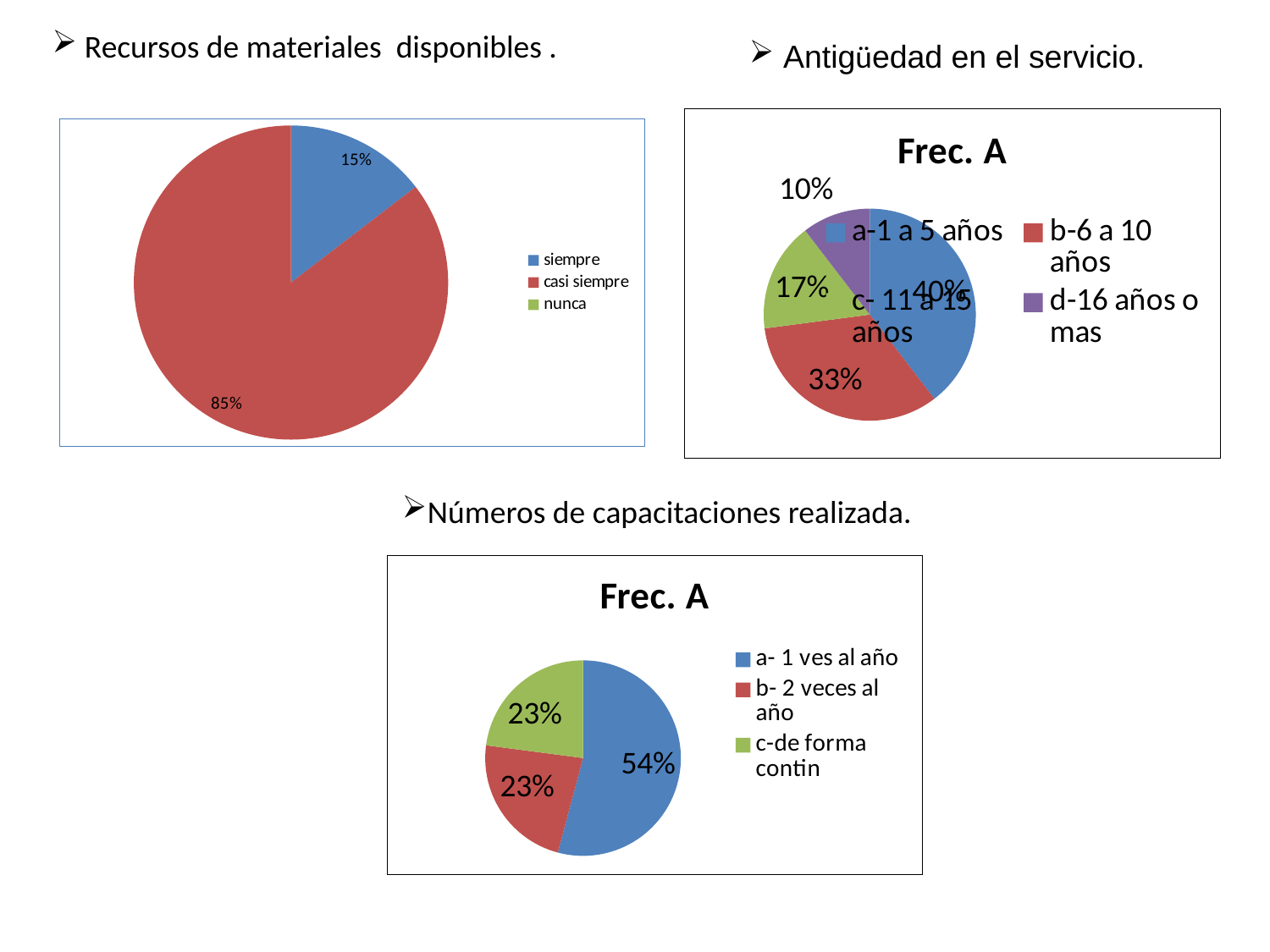
In the top-right pie chart (Antigüedad en el servicio), which category has the smallest slice? d-16 años o mas In the top-right pie chart (Antigüedad en el servicio), what percentage is shown for 'a-1 a 5 años'? 40% In the bottom pie chart (Números de capacitaciones realizada), what percentage is shown for 'a- 1 ves al año'? 54% In the top-right pie chart (Antigüedad en el servicio), what is the difference between the 'b-6 a 10 años' and 'c- 11 a 15 años' percentages? 16% How many categories does the top-right pie chart (Antigüedad en el servicio) show? 4 How many entries does the legend of the top-left pie chart (Recursos de materiales disponibles) list? 3 In the bottom pie chart (Números de capacitaciones realizada), which is larger: 'a- 1 ves al año' or 'b- 2 veces al año'? a- 1 ves al año What type of chart is the bottom chart (Números de capacitaciones realizada)? Pie chart In the top-right pie chart (Antigüedad en el servicio), what percentage is shown for 'd-16 años o mas'? 10% In the top-left pie chart (Recursos de materiales disponibles), what percentage is shown for 'siempre'? 15% In the top-left pie chart (Recursos de materiales disponibles), which category has the largest slice? casi siempre In the top-left pie chart (Recursos de materiales disponibles), what percentage is shown for 'casi siempre'? 85%